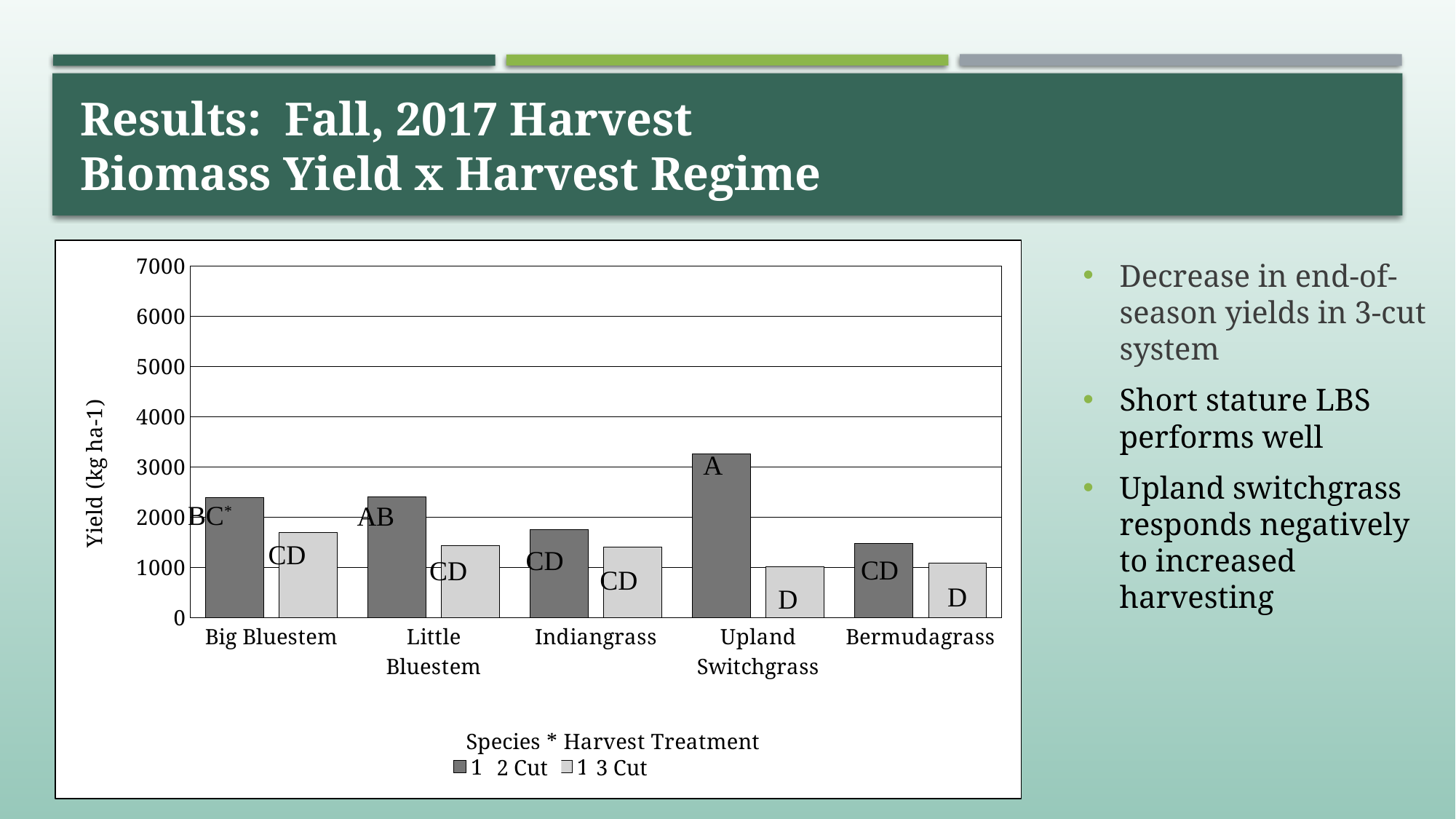
How many series does the chart legend list? 2 Is the 2 Cut yield for Big Bluestem greater or less than 2000? greater Is the 3 Cut yield for Bermudagrass greater or less than 2000? less Which species has the lowest 3 Cut yield in the chart? Upland Switchgrass What is the label on the y axis of the chart? Yield (kg ha-1) Is the 3 Cut yield for Indiangrass greater or less than 1000? greater What significance letter is printed on the 2 Cut bar for Upland Switchgrass? A For Upland Switchgrass, which is larger: the 2 Cut yield or the 3 Cut yield? 2 Cut How many species categories are shown on the x axis of the chart? 5 Which species has the highest 2 Cut yield in the chart? Upland Switchgrass What kind of chart is shown on the slide? bar chart